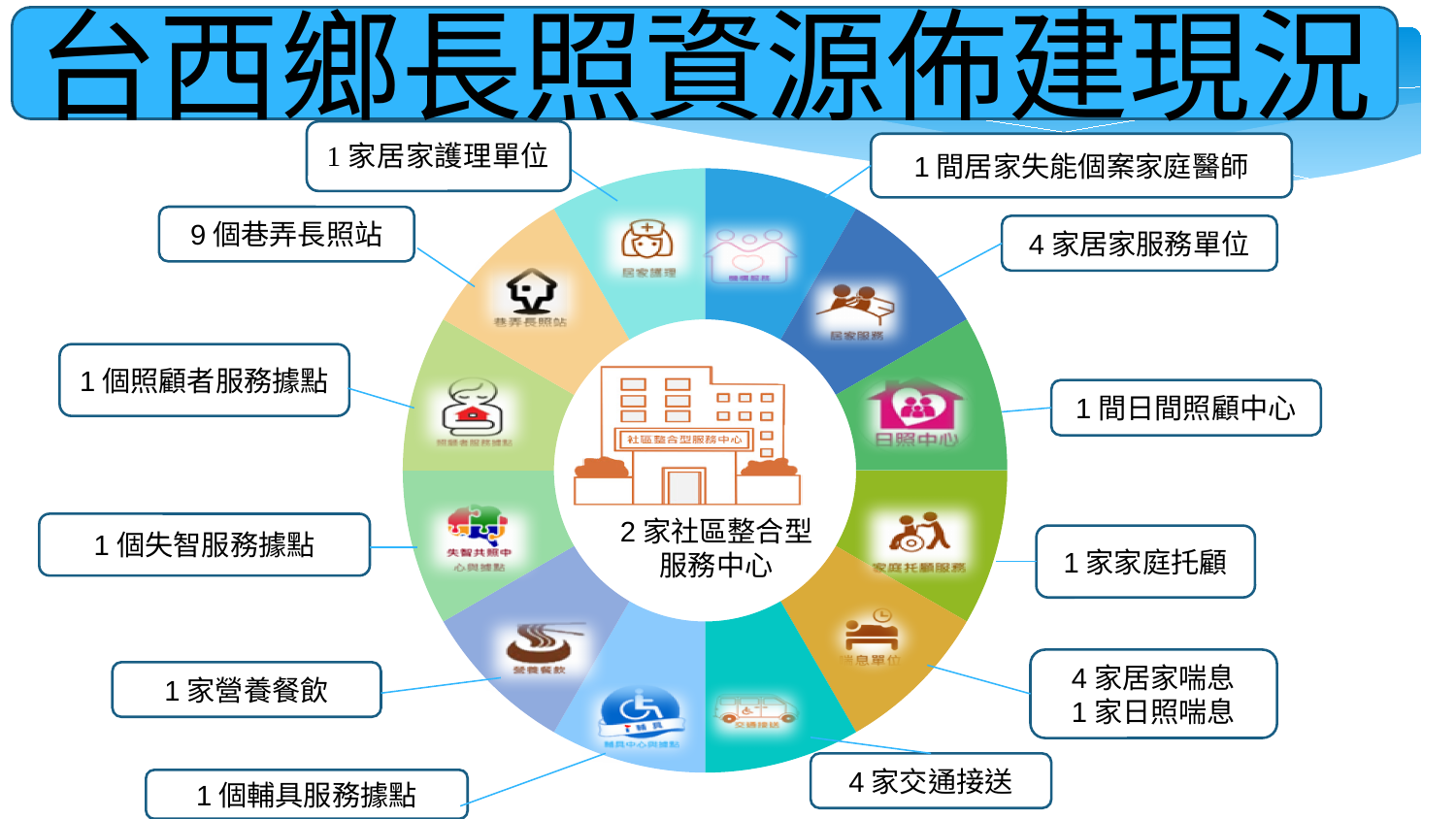
According to the ring diagram, how many 巷弄長照站 are there in 台西鄉? 9 個 How many 失智服務據點 are shown? 1 個 How many 交通接送 providers are listed on the diagram? 4 家 What is the difference between the number of 巷弄長照站 (9) and the number of 交通接送 providers (4)? 5 Which is larger: the number of 巷弄長照站 or the number of 居家服務單位? 巷弄長照站 Which resource type has the largest number of units on the diagram? 巷弄長照站 (9 個) How many 日間照顧中心 are shown? 1 間 How many segments make up the ring diagram around the centre? 12 What is the title of the slide? 台西鄉長照資源佈建現況 How many 居家服務單位 does the diagram show? 4 家 How many 社區整合型服務中心 are shown in the centre of the ring? 2 家 How many 居家喘息 providers are listed in the callout for the 喘息單位 segment? 4 家